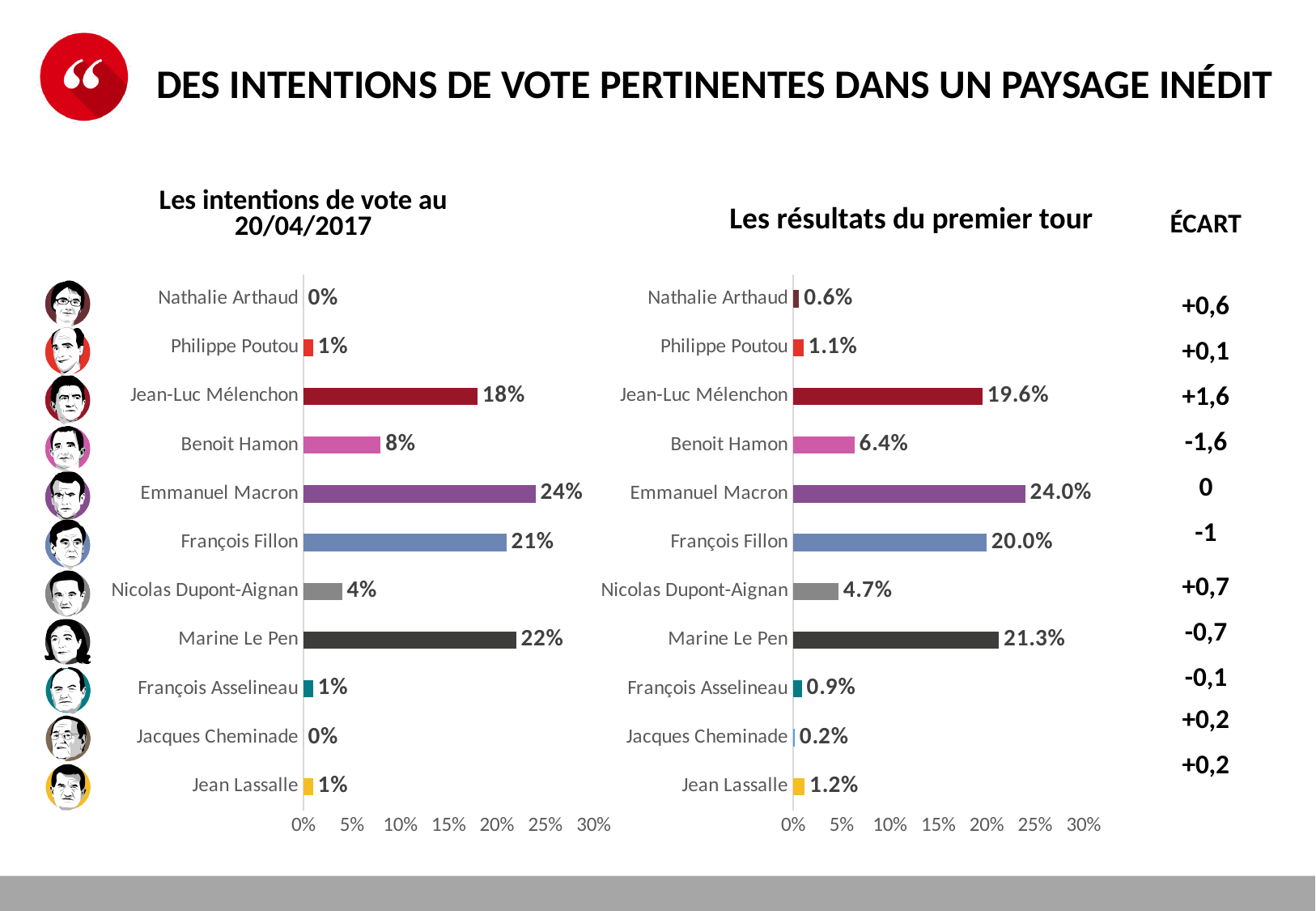
In the chart 'Les résultats du premier tour', which candidate has the lowest value? Jacques Cheminade In the chart 'Les résultats du premier tour', what is the value for Marine Le Pen? 21.3% In the chart 'Les intentions de vote au 20/04/2017', is the value for Jean-Luc Mélenchon greater or less than 15%? greater What is the title of the chart on the right side of the slide? Les résultats du premier tour What kind of chart is 'Les intentions de vote au 20/04/2017'? Bar chart In the chart 'Les résultats du premier tour', which is larger, the value for François Fillon or the value for Marine Le Pen? Marine Le Pen In the chart 'Les intentions de vote au 20/04/2017', what is the difference between Marine Le Pen and François Fillon? 1% In the chart 'Les intentions de vote au 20/04/2017', what is the value for Emmanuel Macron? 24% In the chart 'Les résultats du premier tour', what is the value for Jean-Luc Mélenchon? 19.6% In the chart 'Les résultats du premier tour', what is the difference between Emmanuel Macron and Benoit Hamon? 17.6% How many candidates are shown in the chart 'Les résultats du premier tour'? 11 In the chart 'Les intentions de vote au 20/04/2017', which candidate has the highest value? Emmanuel Macron